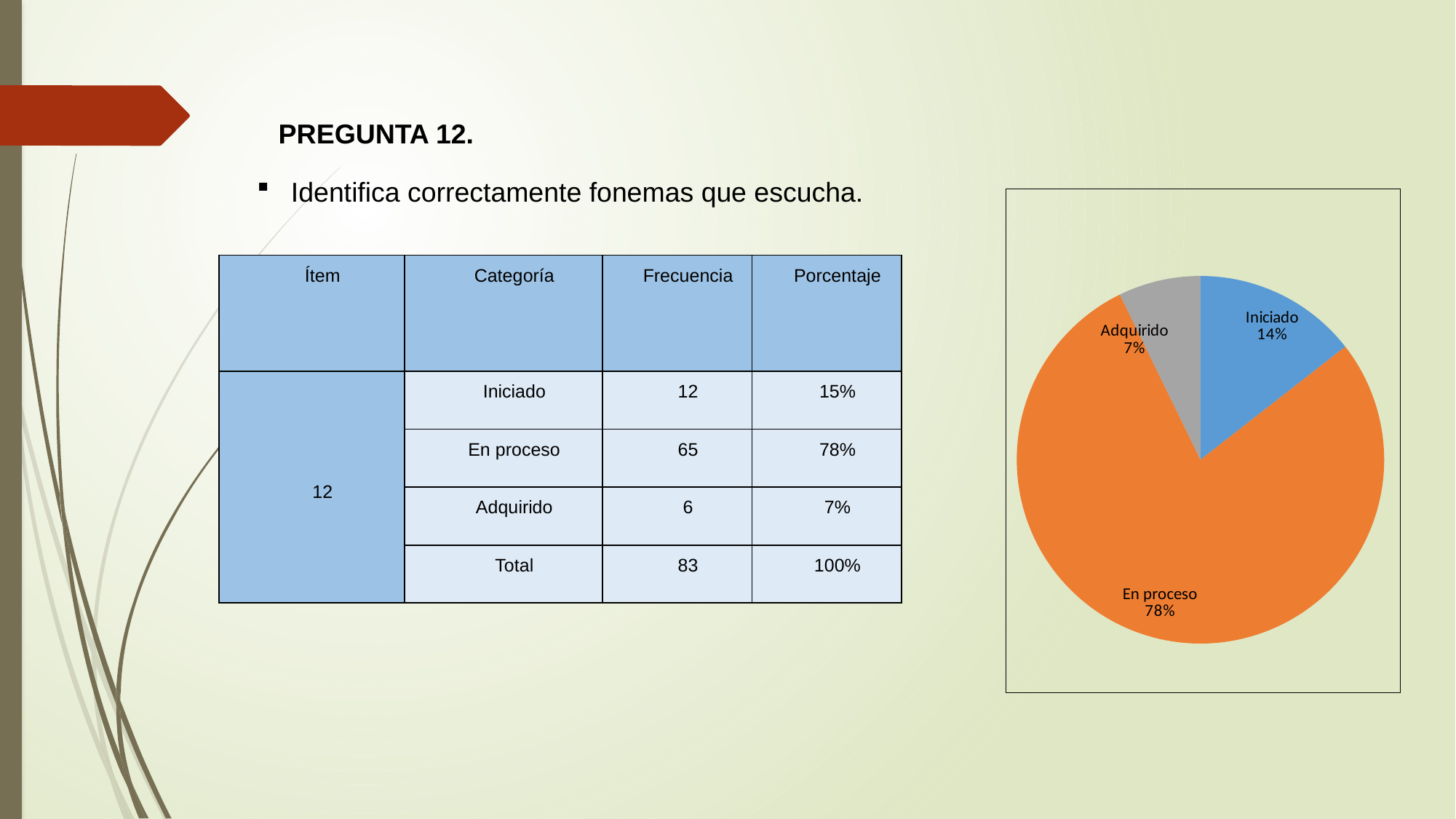
In the pie chart, what is the difference in percentage points between the En proceso slice and the Iniciado slice? 64 What kind of chart is shown on the slide? pie chart What share of the pie chart does the En proceso slice represent? 78% Which category has the largest slice in the pie chart? En proceso What share of the pie chart does the Iniciado slice represent? 14% In the pie chart, what is the difference in percentage points between the Iniciado slice and the Adquirido slice? 7 How many slices does the pie chart have? 3 What colour is the Iniciado slice in the pie chart? blue What colour is the En proceso slice in the pie chart? orange What share of the pie chart does the Adquirido slice represent? 7% In the pie chart, which slice is larger, Iniciado or Adquirido? Iniciado Which category has the smallest slice in the pie chart? Adquirido